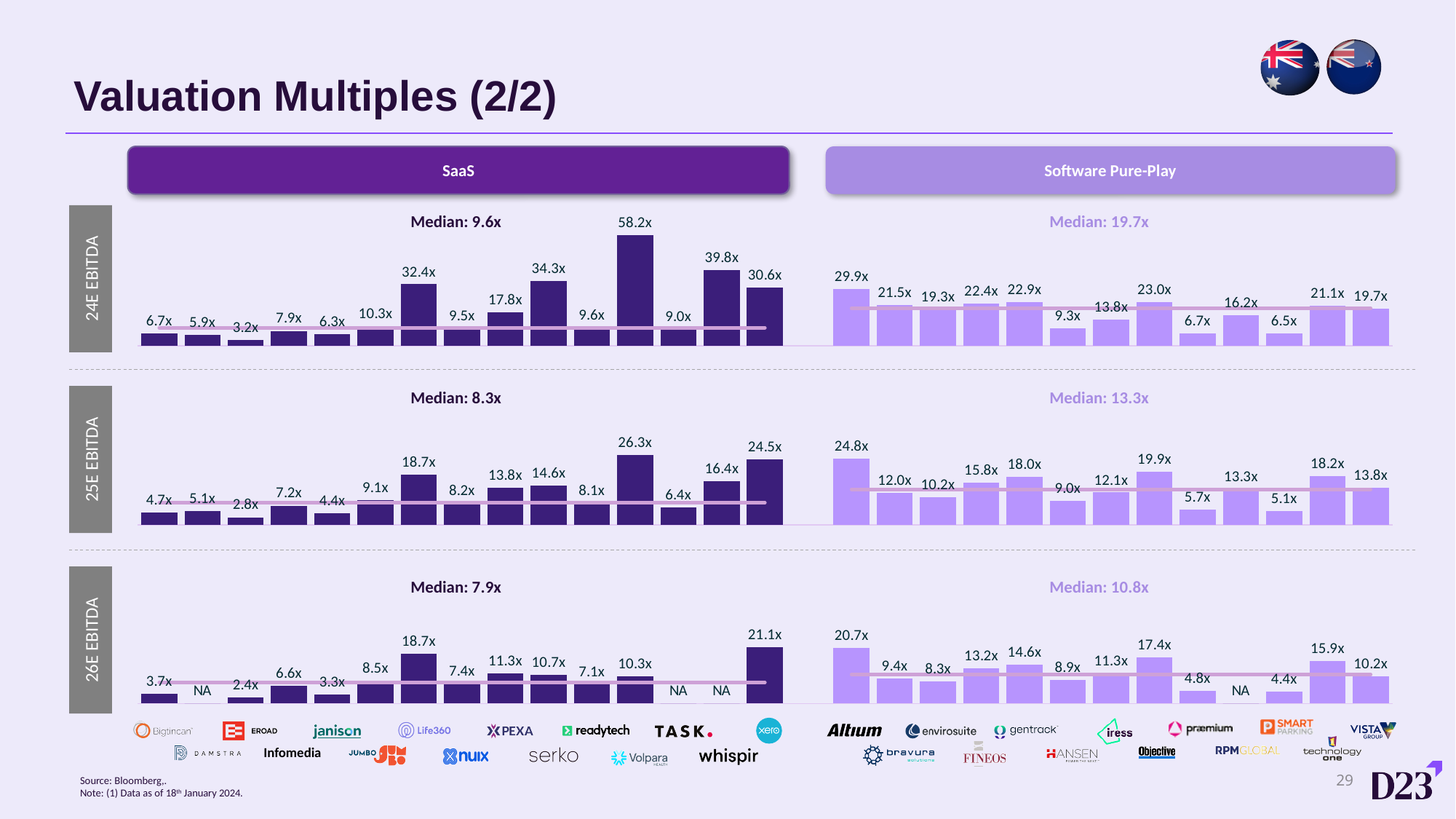
In the SaaS 26E EBITDA chart, how many companies are marked NA? 3 In the Software Pure-Play 24E EBITDA chart, what is the highest multiple plotted? 29.9x In the Software Pure-Play 26E EBITDA chart, what is the median multiple shown? 10.8x What type of chart is used for the 25E EBITDA SaaS multiples? Bar chart In the Software Pure-Play 25E EBITDA chart, what is the lowest multiple plotted? 5.1x In the SaaS 24E EBITDA chart, what is the highest multiple plotted? 58.2x In the SaaS 24E EBITDA chart, what is the lowest multiple plotted? 3.2x How many bars are plotted in the Software Pure-Play 24E EBITDA chart? 13 How many bars are plotted in the SaaS 24E EBITDA chart? 15 Which group has the higher 25E EBITDA median, SaaS or Software Pure-Play? Software Pure-Play What is the difference between the Software Pure-Play 24E EBITDA median and the SaaS 24E EBITDA median? 10.1x In the SaaS 24E EBITDA chart, what is the median multiple shown? 9.6x